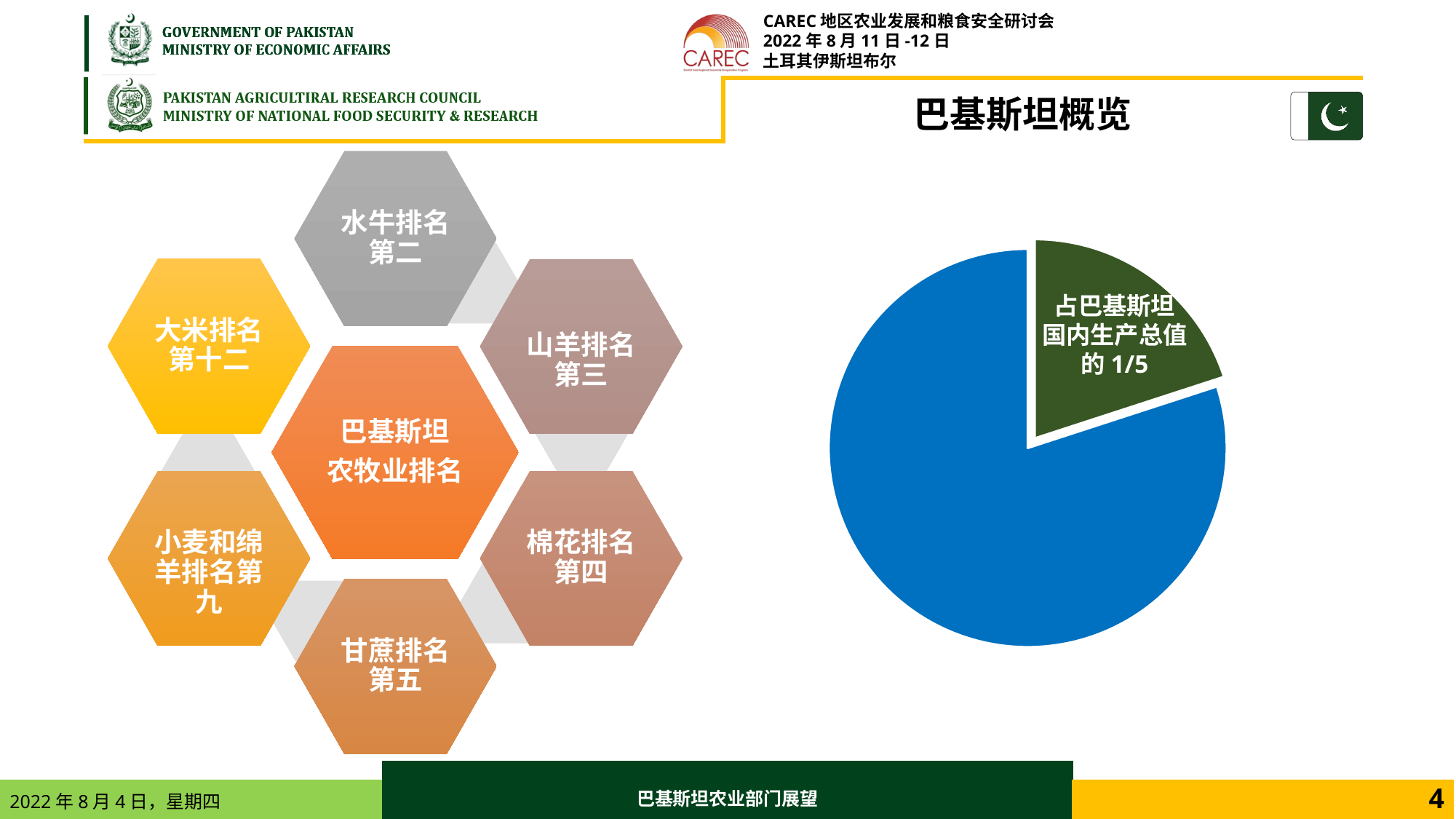
In the pie chart, which slice is the smallest? the green slice (占巴基斯坦国内生产总值的 1/5) What colour is the largest slice of the pie chart? blue In the pie chart, which slice is larger, the blue one or the green one? the blue one How many slices does the pie chart on the right have? 2 In the pie chart, what share of Pakistan's GDP does the green slice represent? 1/5 Is the green slice of the pie chart pulled out (exploded) from the rest of the pie? yes What is the label printed on the green slice of the pie chart? 占巴基斯坦国内生产总值的 1/5 What kind of chart is shown on the right side of the slide? pie chart